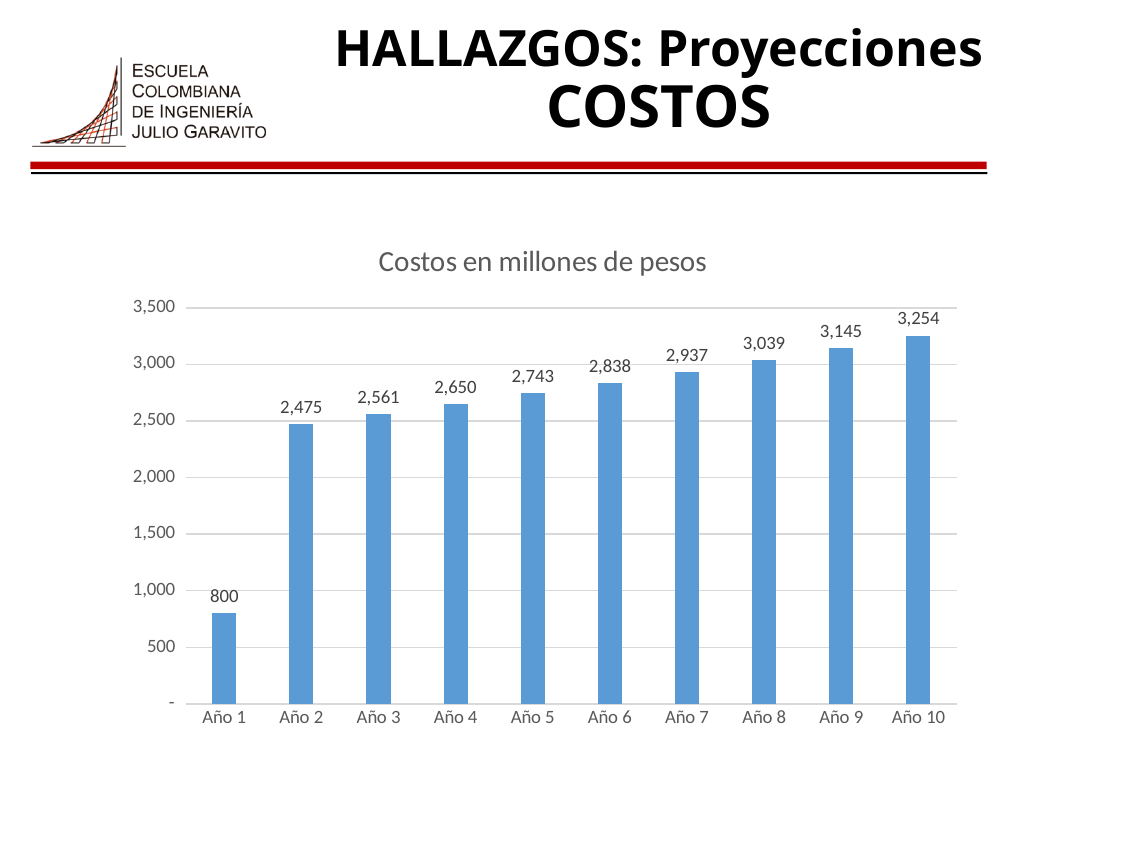
Which is larger, the value for Año 7 or the value for Año 4? Año 7 What is the value for Año 5? 2,743 Which year has the highest value? Año 10 What is the difference between the values for Año 10 and Año 1? 2,454 Which year has the lowest value? Año 1 What is the value for Año 1? 800 What is the value for Año 10? 3,254 Is the value for Año 8 greater or less than 3,000? greater Do the values rise or fall from Año 1 to Año 10? Rise How many years are shown on the x axis? 10 What kind of chart is shown on the slide? Bar chart What is the difference between the values for Año 3 and Año 2? 86